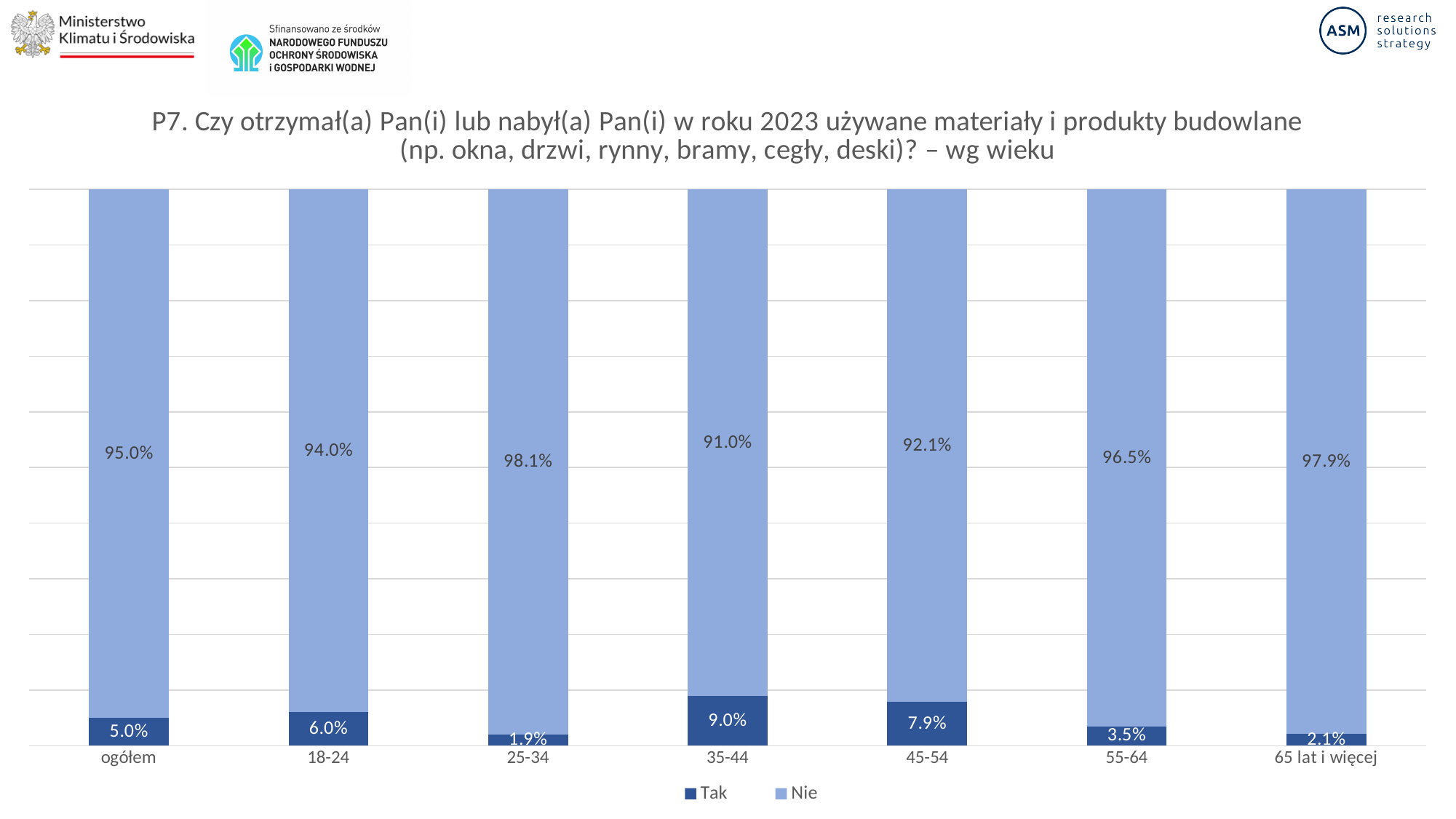
What kind of chart is shown on the slide? stacked bar chart How many categories are shown on the x axis? 7 What is the value of "Tak" for the 35-44 age group? 9.0% How many series does the legend list? 2 What is the value of "Tak" for "ogółem"? 5.0% What is the difference between the "Tak" values for 35-44 and 18-24? 3.0% Which series is shown in dark blue in the legend? Tak What is the value of "Nie" for the 25-34 age group? 98.1% Which age category has the highest "Tak" value? 35-44 What is the total of the stacked bar for the 65 lat i więcej category? 100.0% Which age category has the lowest "Tak" value? 25-34 Which is larger: the "Nie" value for 55-64 or for 45-54? 55-64